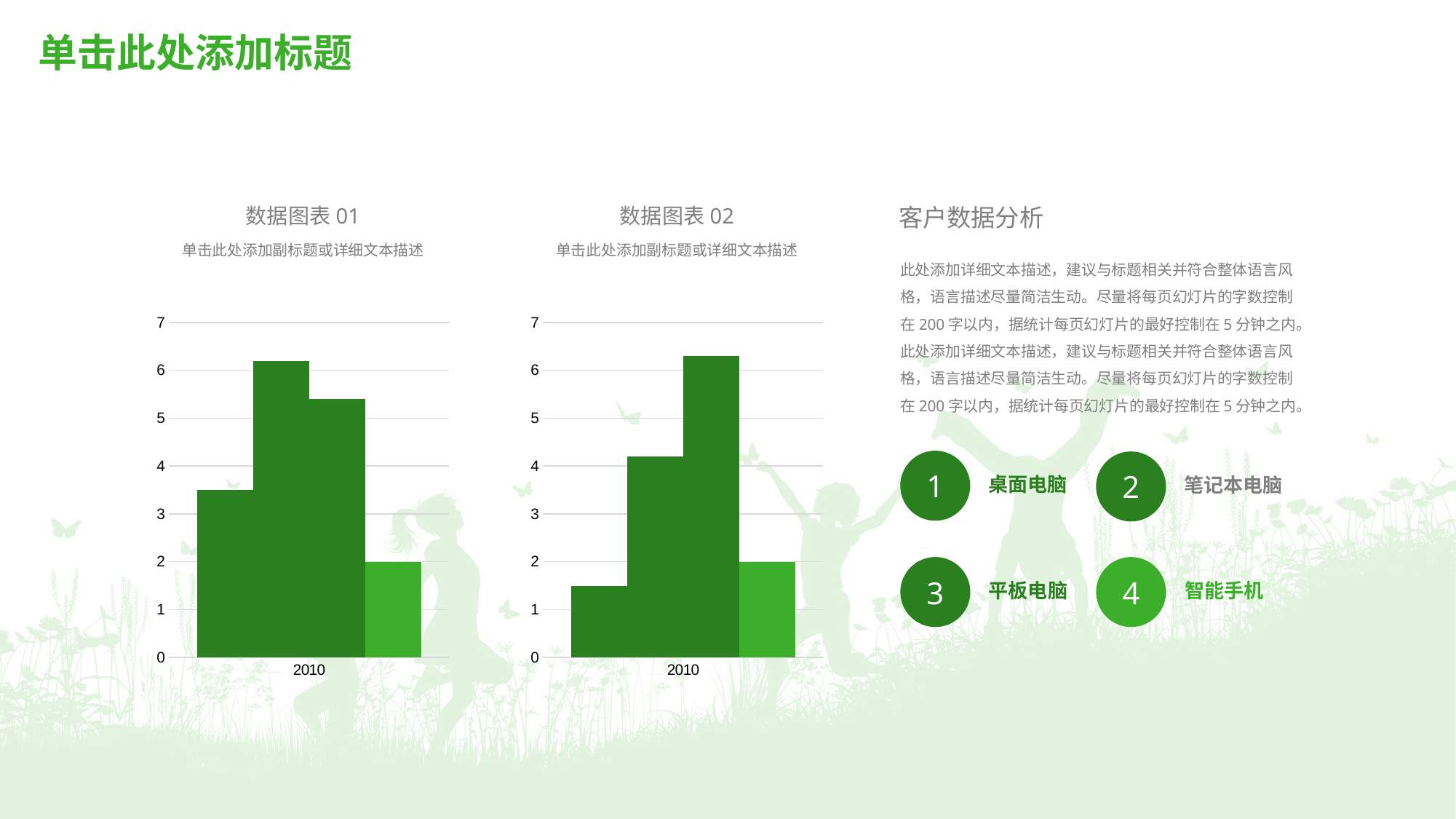
In 数据图表 02, which is larger: the second bar from the left or the fourth bar from the left? the second bar In 数据图表 01, is the value of the second bar from the left greater or less than 6? greater What kind of chart is 数据图表 02? bar chart What kind of chart is 数据图表 01? bar chart In 数据图表 01, which bar is the tallest: the first, second, third or fourth from the left? second In 数据图表 02, is the value of the first bar from the left greater or less than 2? less What is the highest value shown on the y axis of 数据图表 01? 7 In 数据图表 02, which bar is the shortest: the first, second, third or fourth from the left? first In 数据图表 02, which bar is the tallest: the first, second, third or fourth from the left? third In 数据图表 02, what is the only category label shown on the x axis? 2010 In 数据图表 01, which bar is the shortest: the first, second, third or fourth from the left? fourth In 数据图表 01, how many bars are plotted? 4